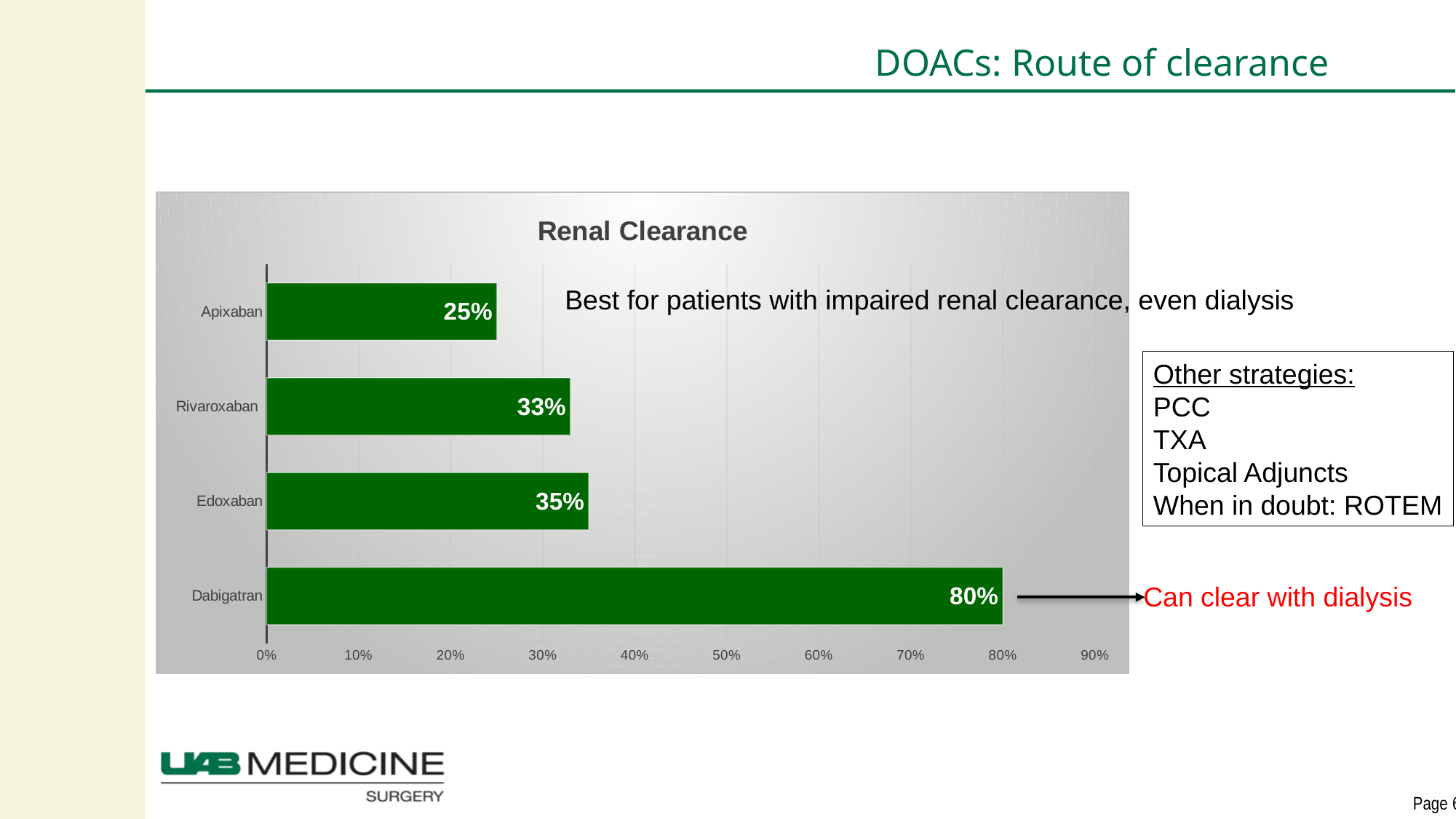
What is the difference in renal clearance between Edoxaban and Rivaroxaban? 2% What is the renal clearance value for Edoxaban? 35% Which drug has the lowest renal clearance? Apixaban What is the difference in renal clearance between Dabigatran and Apixaban? 55% What is the renal clearance value for Apixaban? 25% What is the renal clearance value for Rivaroxaban? 33% What is the renal clearance value for Dabigatran? 80% How many drugs are shown in the chart? 4 What is the title of the chart? Renal Clearance Which drug has the highest renal clearance? Dabigatran What type of chart is shown on the slide? Bar chart Which has a higher renal clearance, Rivaroxaban or Dabigatran? Dabigatran